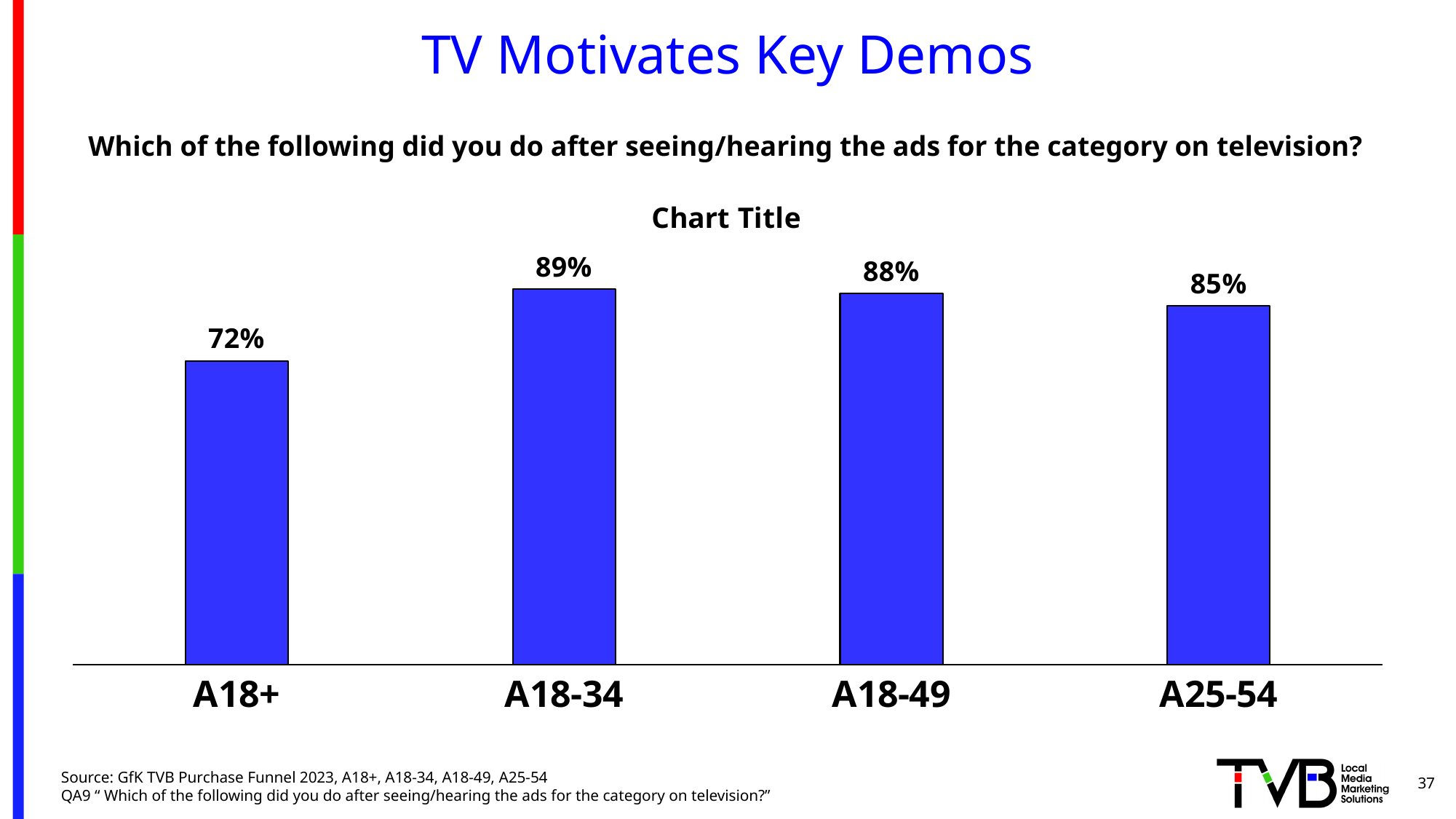
How many categories are shown on the chart? 4 What is the difference between the values for A18-49 and A25-54? 3% What kind of chart is shown on the slide? Bar chart What is the value for A18-34? 89% What is the value for A18+? 72% Which is larger, the value for A18+ or the value for A25-54? A25-54 What is the value for A25-54? 85% Which category has the lowest value? A18+ What is the title printed above the chart? Chart Title What is the value for A18-49? 88% Which category has the highest value? A18-34 What is the difference between the values for A18-34 and A18+? 17%